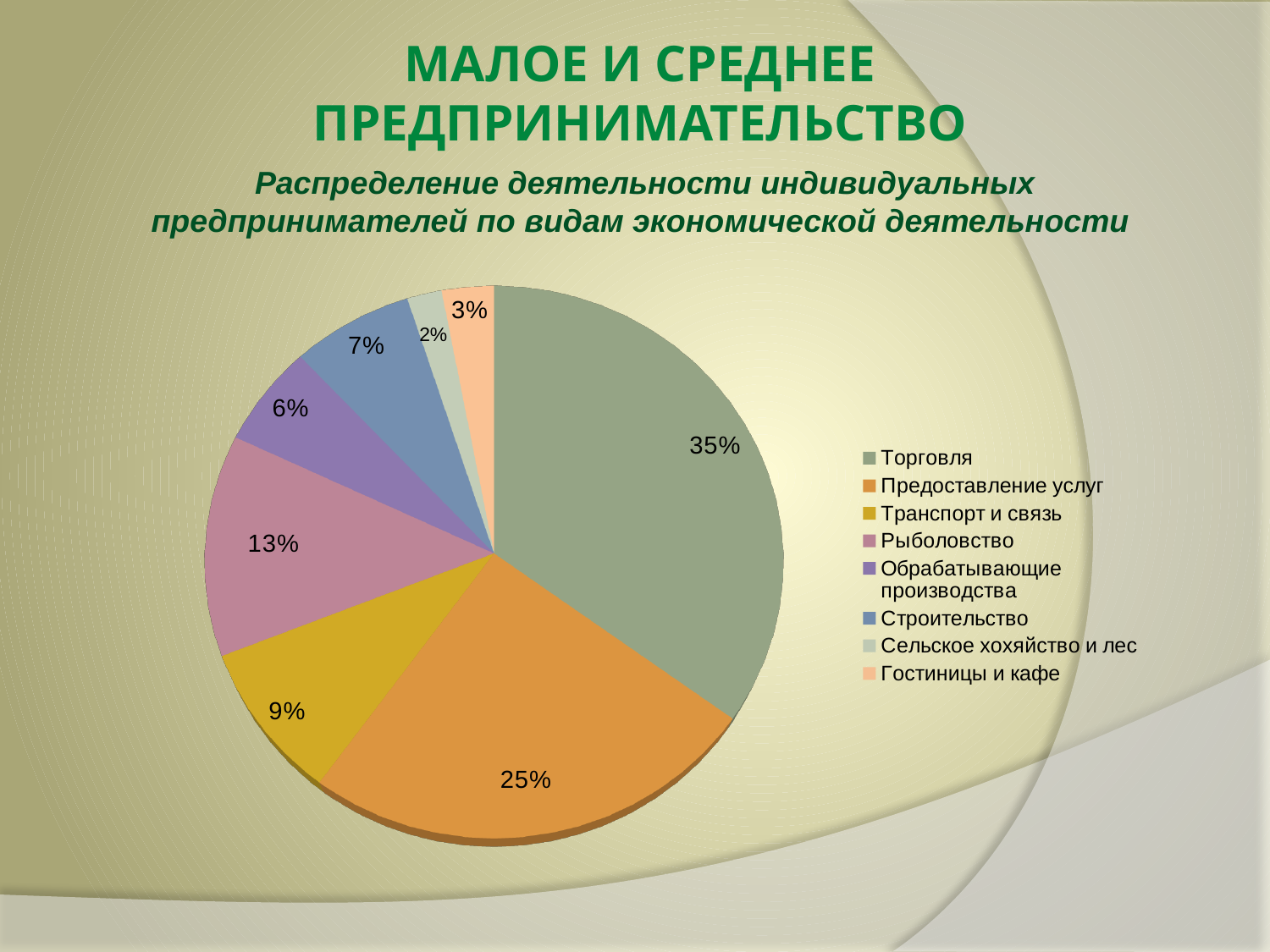
What is the value shown for Предоставление услуг? 25% What is the value shown for Транспорт и связь? 9% Which category has the largest slice of the pie? Торговля What is the difference between the shares of Торговля and Предоставление услуг? 10% How many categories does the legend list? 8 Which is larger, the share of Рыболовство or the share of Транспорт и связь? Рыболовство What is the value shown for Гостиницы и кафе? 3% What share of the pie does Торговля have? 35% What kind of chart is shown on the slide? Pie chart Which category has the smallest slice of the pie? Сельское хохяйство и лес What is the value shown for Рыболовство? 13% What is the value shown for Строительство? 7%